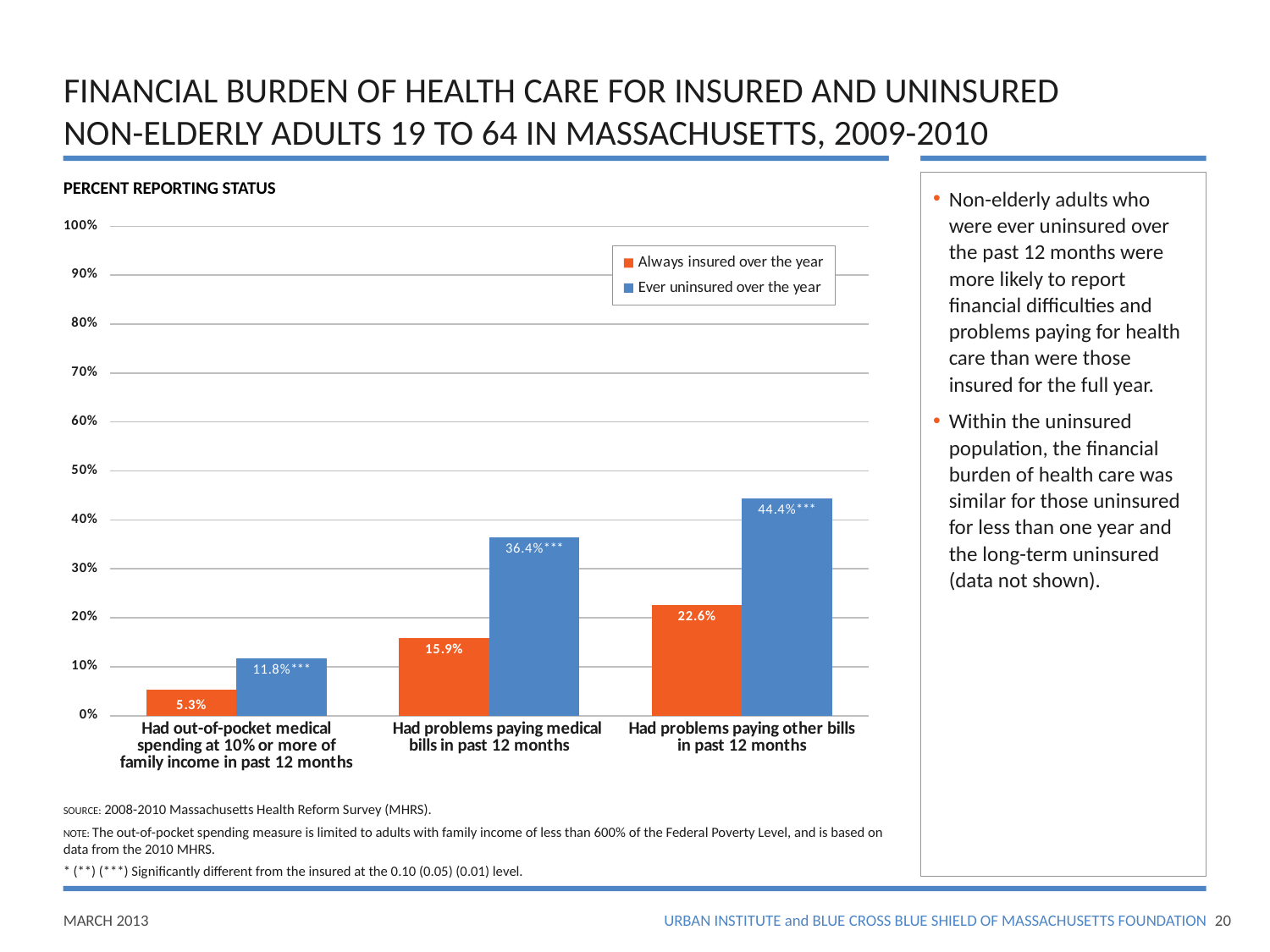
What percentage of adults always insured over the year had problems paying other bills in the past 12 months? 22.6% What percentage of adults ever uninsured over the year had problems paying medical bills in the past 12 months? 36.4% What percentage of adults ever uninsured over the year had out-of-pocket medical spending at 10% or more of family income? 11.8% How many categories are shown on the x axis of the chart? 3 For having problems paying other bills, which group has the larger value: always insured or ever uninsured? Ever uninsured over the year Which category has the highest value for adults ever uninsured over the year? Had problems paying other bills in past 12 months What kind of chart is shown on the slide? Bar chart Is the value for ever uninsured adults who had problems paying other bills greater or less than 40%? greater How many series does the chart legend list? 2 Which category has the lowest value for adults always insured over the year? Had out-of-pocket medical spending at 10% or more of family income in past 12 months What is the difference between the ever uninsured and always insured values for having problems paying medical bills in the past 12 months? 20.5% What percentage of adults always insured over the year had out-of-pocket medical spending at 10% or more of family income in the past 12 months? 5.3%